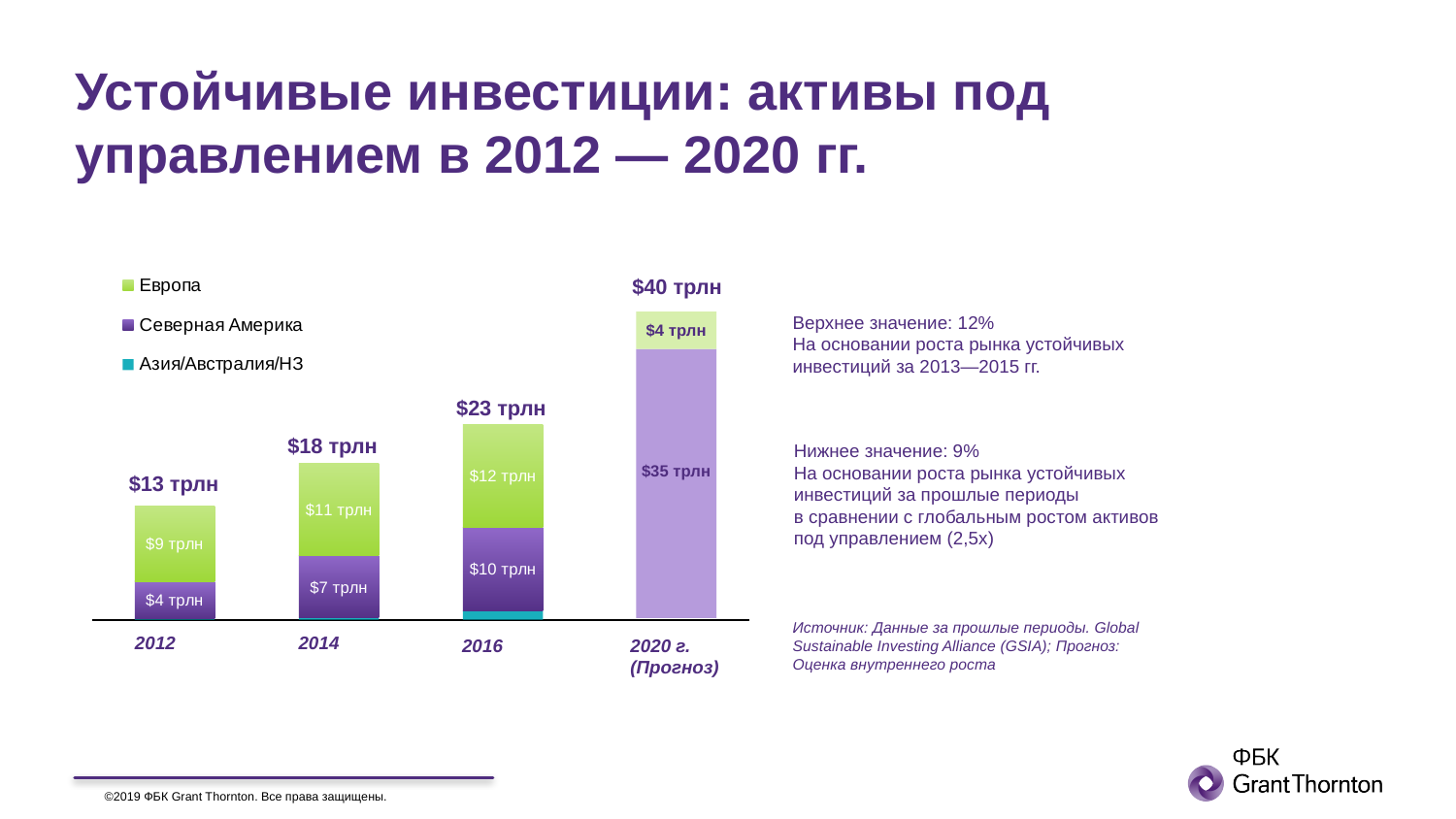
What type of chart is shown on the slide? stacked bar chart Which year has the highest total value? 2020 г. (Прогноз) What is the value for Европа in 2014? $11 трлн How many categories (years) are shown on the x axis? 4 Do the total values rise or fall from 2012 to 2020? rise What is the total value of the bar for 2012? $13 трлн What is the value for Северная Америка in 2016? $10 трлн Which year has the lowest total value? 2012 What is the difference between the total for 2016 and the total for 2014? $5 трлн What is the value for Северная Америка in 2012? $4 трлн What is the total value of the bar for 2020 г. (Прогноз)? $40 трлн How many series does the legend list? 3